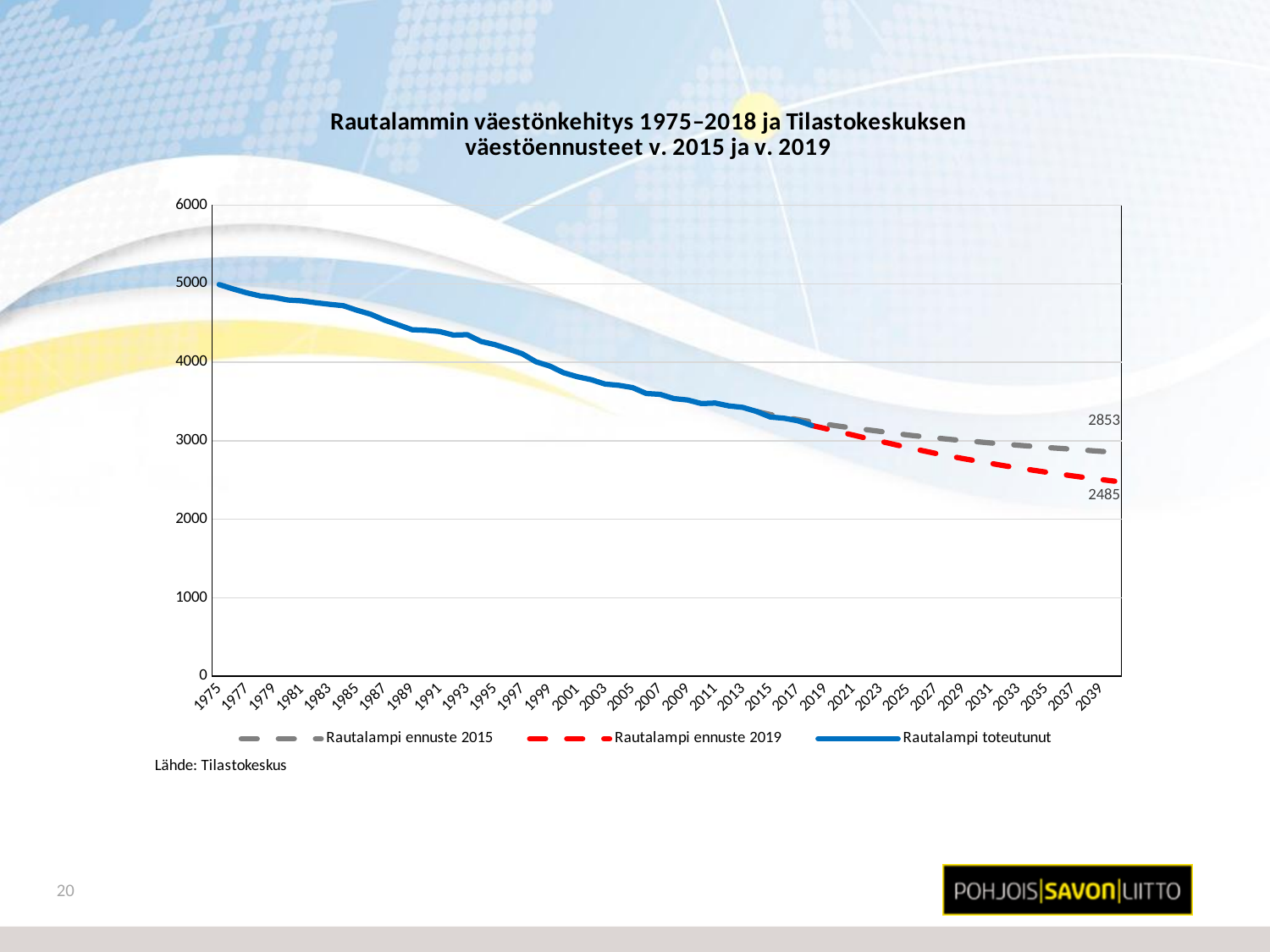
Is the value of Rautalampi toteutunut in 2017 greater or less than 4000? less What is the final labelled value of the Rautalampi ennuste 2015 series? 2853 Is the value of Rautalampi toteutunut in 2009 greater or less than 4000? less Is the value of Rautalampi toteutunut in 1975 greater or less than 4000? greater Which forecast series ends at a higher value, Rautalampi ennuste 2015 or Rautalampi ennuste 2019? Rautalampi ennuste 2015 What is the difference between the final labelled values of the 2015 forecast (2853) and the 2019 forecast (2485)? 368 Does the Rautalampi toteutunut series rise or fall from 1975 to 2018? fall What colour is the Rautalampi ennuste 2019 line? red What is the final labelled value of the Rautalampi ennuste 2019 series? 2485 How many series does the legend list? 3 What kind of chart is shown on the slide? line chart What source is cited below the chart? Tilastokeskus